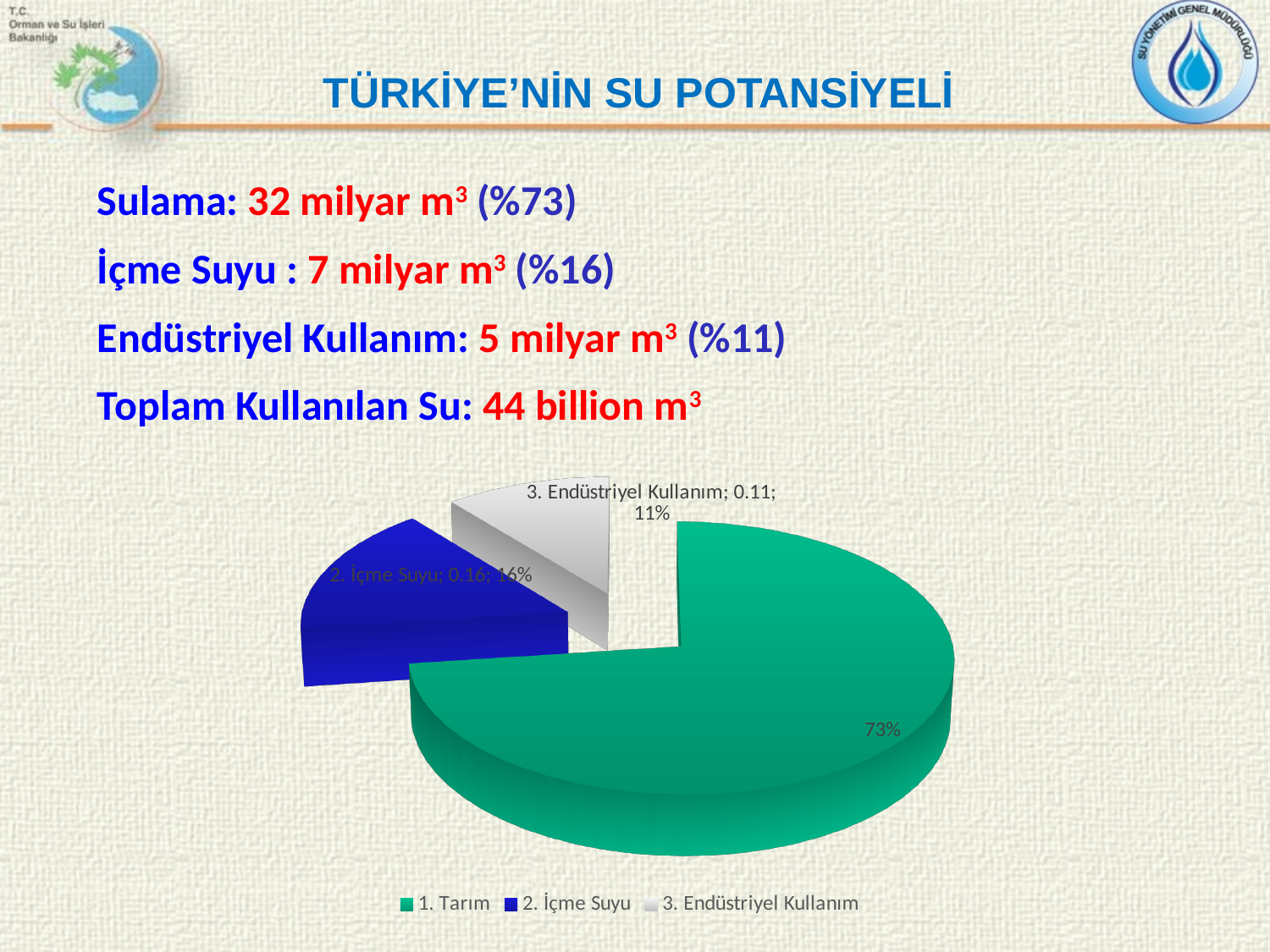
What value is printed in the data label for 3. Endüstriyel Kullanım? 0.11; 11% What share of the pie does the slice for 1. Tarım represent? 73% What share of the pie does the slice for 2. İçme Suyu represent? 16% What share of the pie does the slice for 3. Endüstriyel Kullanım represent? 11% Which slice of the pie chart is the largest? 1. Tarım How many entries does the legend of the pie chart list? 3 Which colour is used for the 2. İçme Suyu slice in the pie chart? blue What kind of chart is shown on the slide? pie chart How many slices does the pie chart have? 3 Which slice of the pie chart is the smallest? 3. Endüstriyel Kullanım What value is printed in the data label for 2. İçme Suyu? 0.16; 16% What is the difference in percentage points between the 1. Tarım slice and the 2. İçme Suyu slice? 57